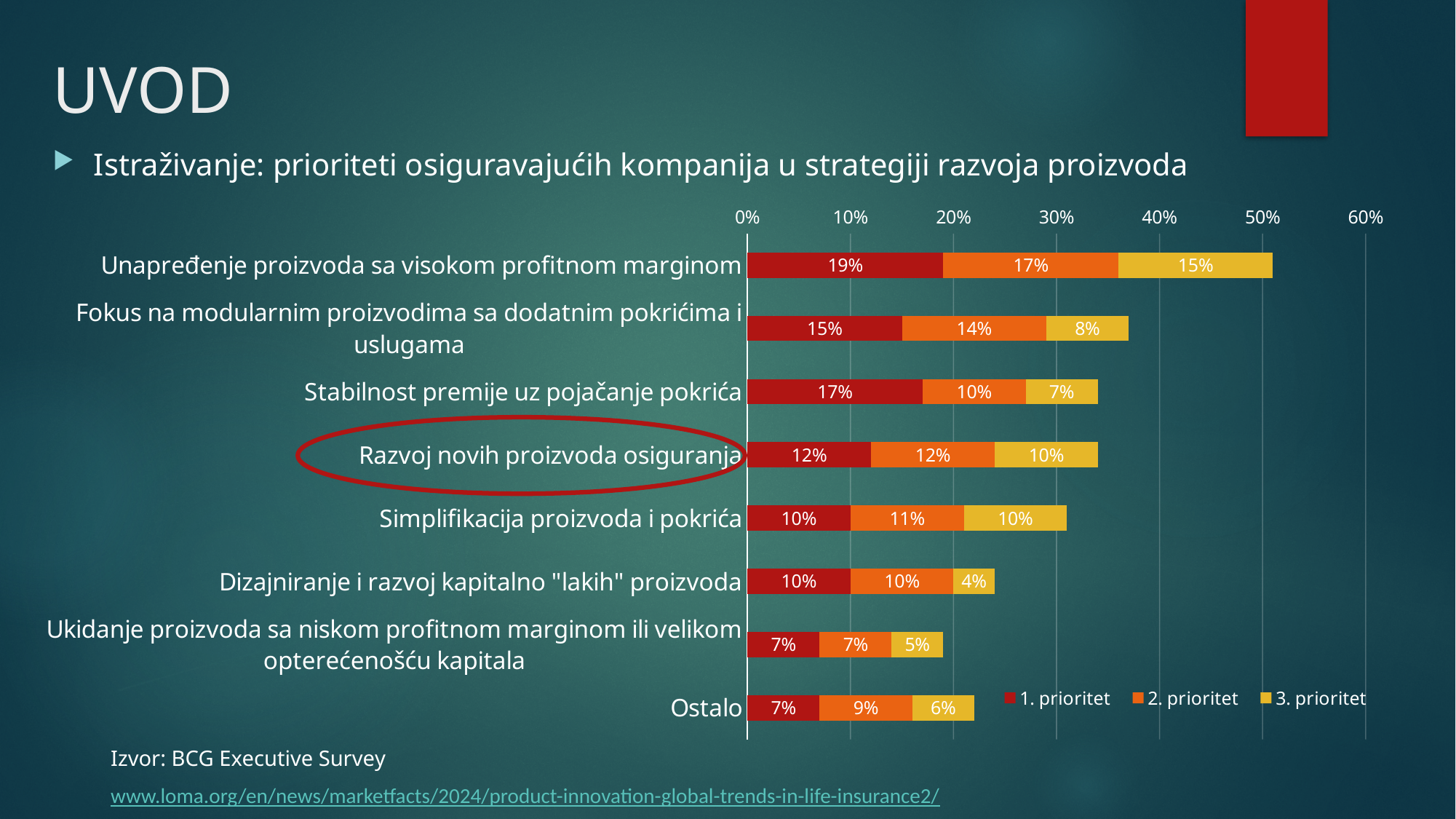
Which category has the highest '1. prioritet' value? Unapređenje proizvoda sa visokom profitnom marginom What is the difference between the '1. prioritet' values for 'Stabilnost premije uz pojačanje pokrića' and 'Simplifikacija proizvoda i pokrića'? 7% How many categories are plotted in the chart? 8 What is the total of the stacked bar for 'Razvoj novih proizvoda osiguranja'? 34% Which category has the lowest '3. prioritet' value? Dizajniranje i razvoj kapitalno "lakih" proizvoda What is the value of '1. prioritet' for 'Unapređenje proizvoda sa visokom profitnom marginom'? 19% What is the value of '3. prioritet' for 'Fokus na modularnim proizvodima sa dodatnim pokrićima i uslugama'? 8% What is the value of '2. prioritet' for 'Razvoj novih proizvoda osiguranja'? 12% What is the total of the stacked bar for 'Unapređenje proizvoda sa visokom profitnom marginom'? 51% How many series does the legend list? 3 Which is larger: the '2. prioritet' value for 'Ostalo' or for 'Ukidanje proizvoda sa niskom profitnom marginom ili velikom opterećenošću kapitala'? Ostalo What kind of chart is shown on the slide? stacked bar chart